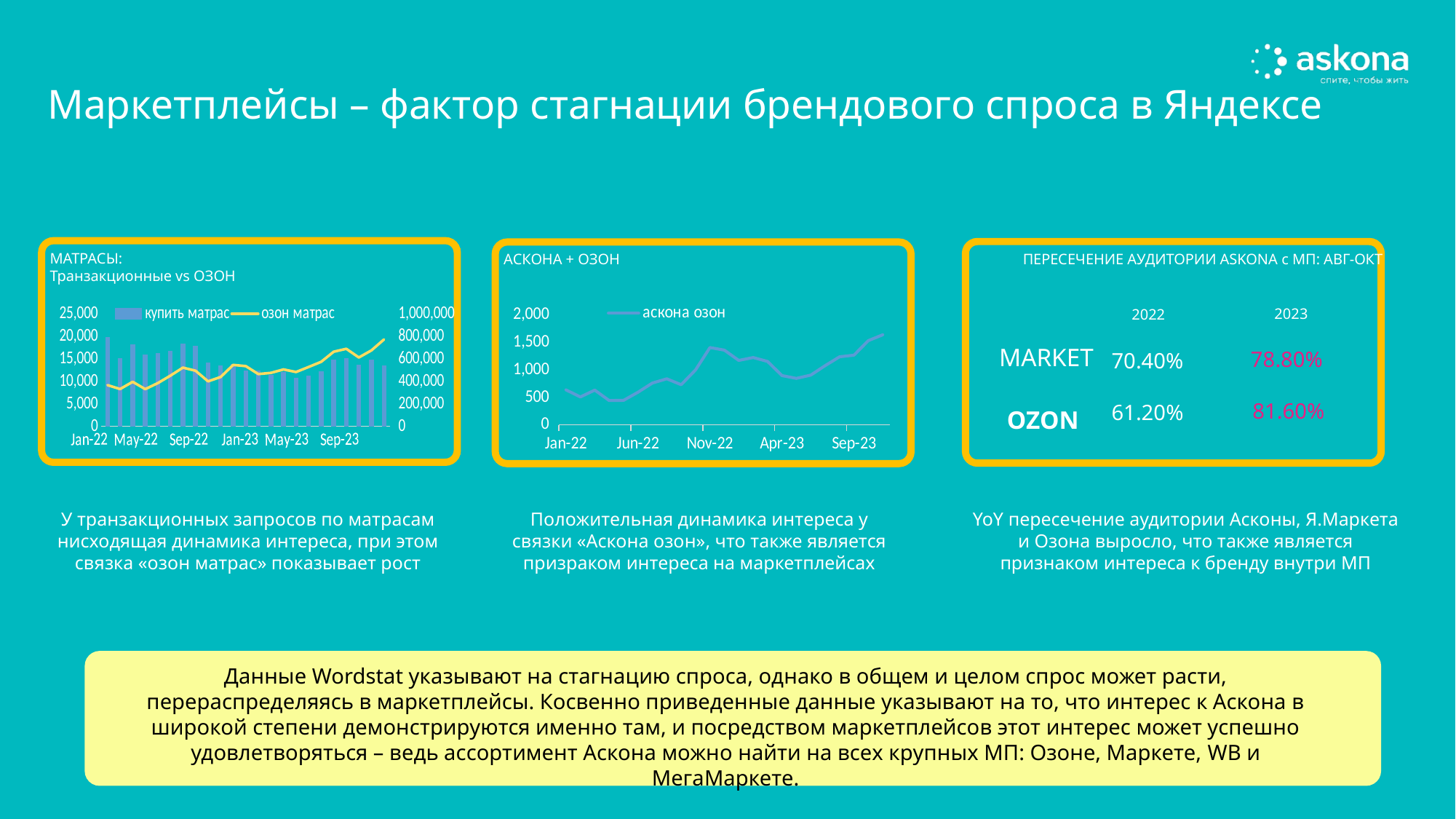
How many series does the legend of the 'МАТРАСЫ: Транзакционные vs ОЗОН' chart list? 2 In the 'АСКОНА + ОЗОН' chart, do the values generally rise or fall from Jan-22 to Sep-23? rise In the 'АСКОНА + ОЗОН' chart, what is the name of the plotted series? аскона озон In the 'МАТРАСЫ: Транзакционные vs ОЗОН' chart, is the 'купить матрас' bar at Jan-22 greater or less than 15,000? greater What kind of chart is the 'АСКОНА + ОЗОН' chart? line chart In the 'МАТРАСЫ: Транзакционные vs ОЗОН' chart, do the 'озон матрас' line values generally rise or fall from Jan-22 to the end of 2023? rise How many series does the legend of the 'АСКОНА + ОЗОН' chart list? 1 In the 'АСКОНА + ОЗОН' chart, is the value at Nov-22 greater or less than 1,000? greater In the 'АСКОНА + ОЗОН' chart, is the value at Jun-22 greater or less than 1,000? less In the 'МАТРАСЫ: Транзакционные vs ОЗОН' chart, which series is drawn as bars? купить матрас In the 'МАТРАСЫ: Транзакционные vs ОЗОН' chart, do the 'купить матрас' bars generally rise or fall from Jan-22 to the end of 2023? fall